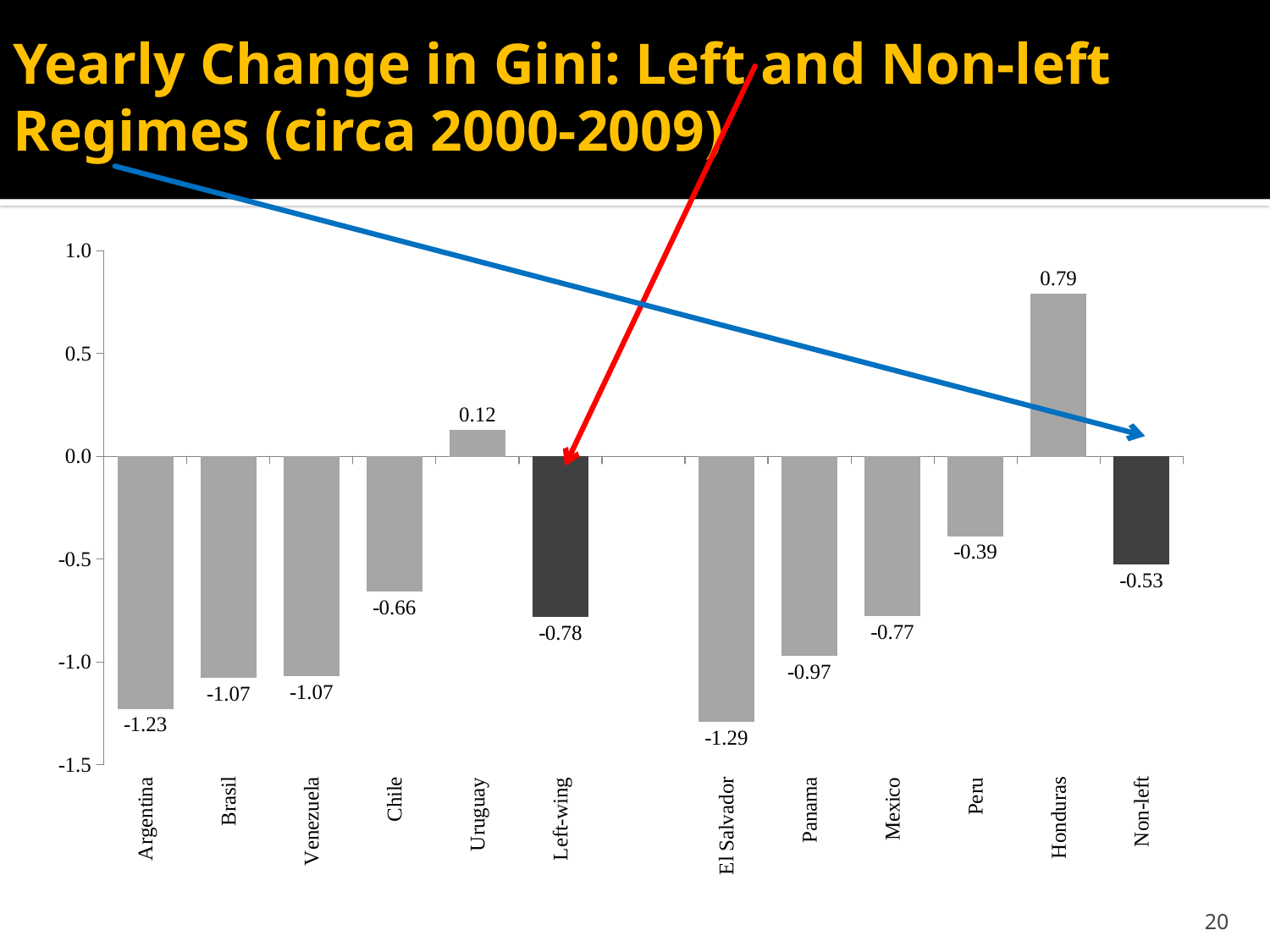
Which two categories are drawn in a darker colour than the rest? Left-wing and Non-left What is the difference between the values for Honduras and Uruguay? 0.67 What is the value for Honduras? 0.79 What kind of chart is shown on the slide? Bar chart Which category has the lowest value? El Salvador Which is larger, the value for Chile or the value for Panama? Chile What is the value for the Non-left bar? -0.53 What is the value for the Left-wing bar? -0.78 What is the value for Argentina? -1.23 What is the difference between the values for Left-wing and Non-left? 0.25 Which category has the highest value? Honduras How many categories are shown on the x axis? 12